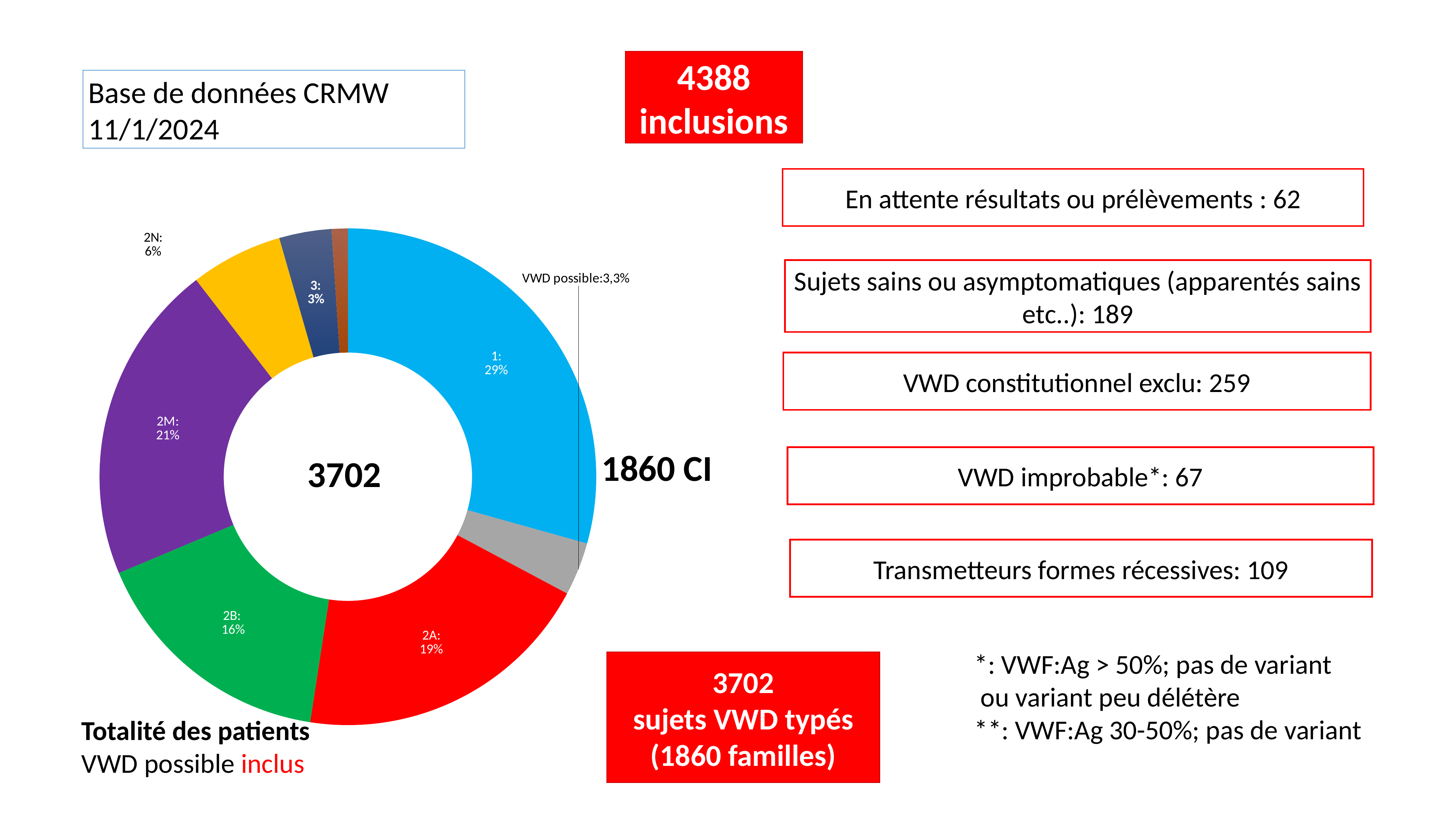
What percentage is shown for type 2B in the doughnut chart? 16% Which labelled category has the smallest share in the doughnut chart? 3 Which has a larger share in the doughnut chart, type 2A or type 2B? 2A What percentage is shown for type 2N in the doughnut chart? 6% What percentage is shown for 'VWD possible' in the doughnut chart? 3,3% What percentage is shown for type 1 in the doughnut chart? 29% Which labelled category has the largest share in the doughnut chart? 1 What percentage is shown for type 2M in the doughnut chart? 21% What is the difference in percentage points between type 2M and type 2B in the doughnut chart? 5 What number is printed in the centre of the doughnut chart? 3702 What kind of chart is shown on the slide? doughnut chart What percentage is shown for type 2A in the doughnut chart? 19%